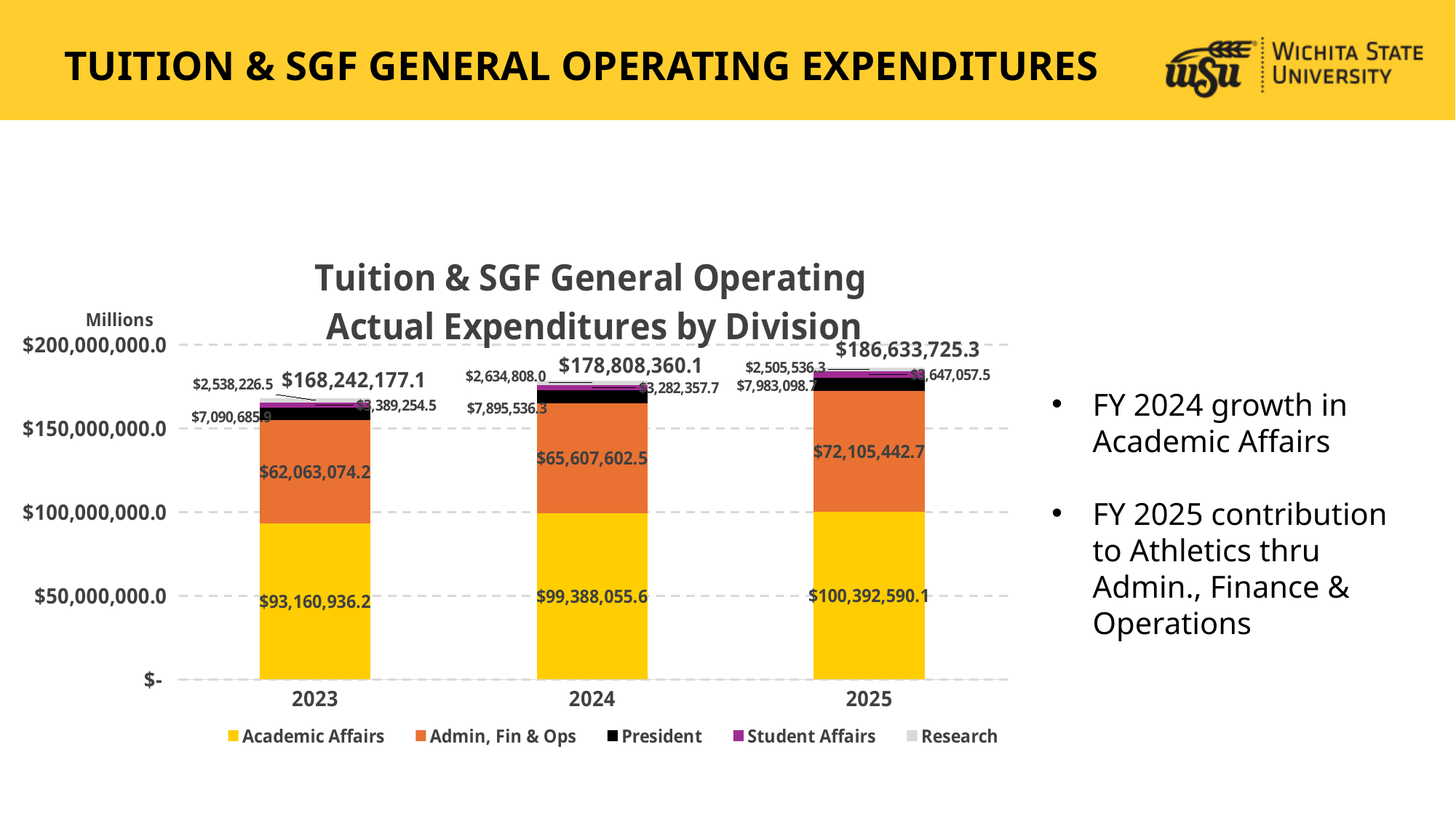
Which is larger, the Admin, Fin & Ops value for 2024 or for 2025? 2025 Which year has the highest total expenditures? 2025 What is the value for Admin, Fin & Ops in 2025? $72,105,442.7 What is the difference between the total expenditures for 2025 and 2024? $7,825,365.2 What is the value for Research in 2024? $2,634,808.0 How many series does the legend list? 5 Do the total expenditures rise or fall from 2023 to 2025? rise What is the value for Academic Affairs in 2024? $99,388,055.6 What is the difference between the Academic Affairs values for 2024 and 2023? $6,227,119.4 What is the value for President in 2024? $7,895,536.3 What kind of chart is shown on the slide? stacked bar chart What is the total of the stacked bar for 2023? $168,242,177.1